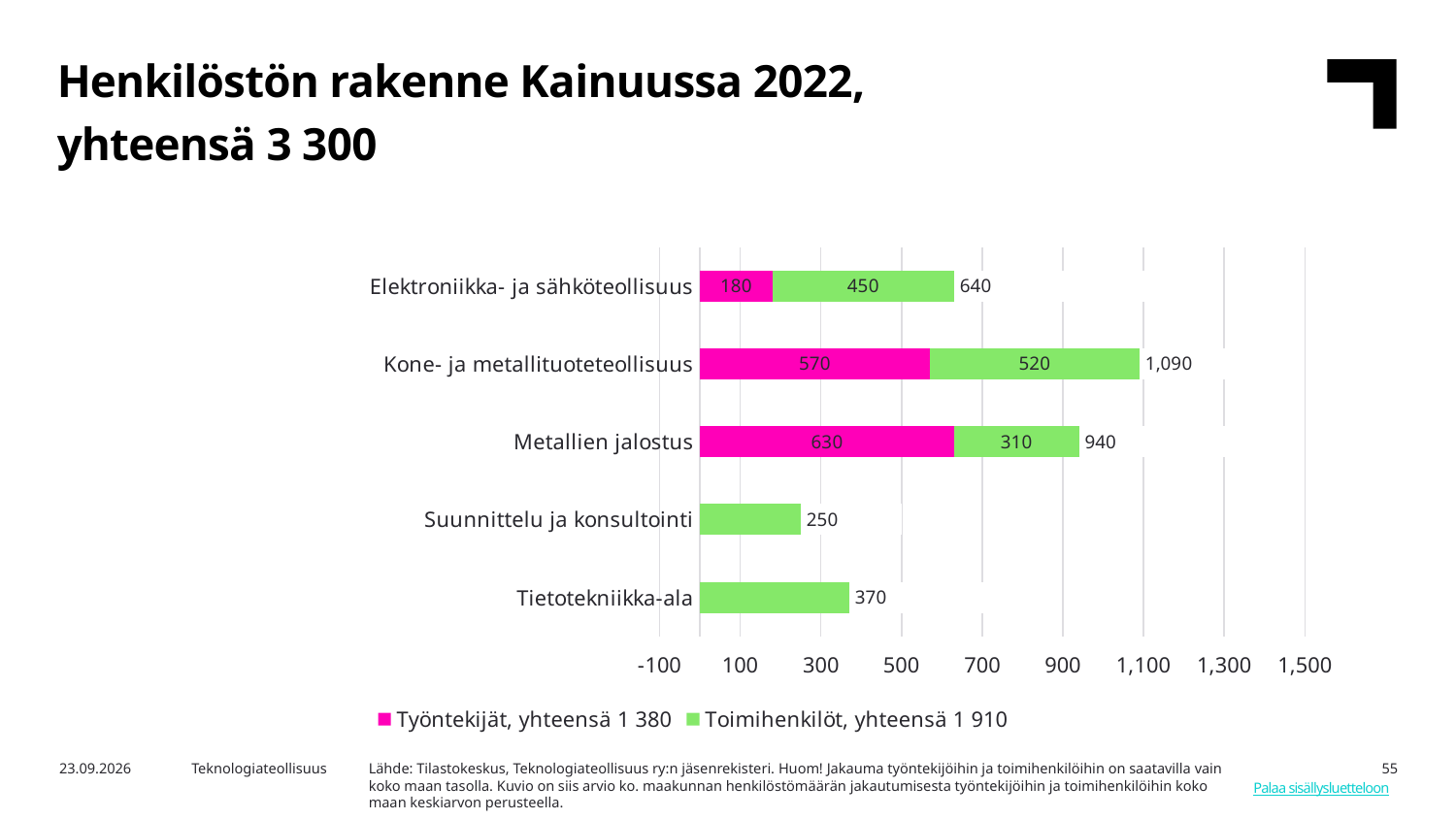
How many categories are shown on the chart? 5 How many series does the legend list? 2 What kind of chart is shown on the slide? Stacked bar chart What is the Toimihenkilöt value for Elektroniikka- ja sähköteollisuus? 450 What is the difference between the Työntekijät values for Metallien jalostus and Elektroniikka- ja sähköteollisuus? 450 What is the Työntekijät value for Kone- ja metallituoteteollisuus? 570 Which category has the lowest total? Suunnittelu ja konsultointi What is the title of the chart slide? Henkilöstön rakenne Kainuussa 2022, yhteensä 3 300 Which category has the highest total? Kone- ja metallituoteteollisuus What is the total for the Metallien jalostus bar? 940 Which is larger: the Toimihenkilöt value for Tietotekniikka-ala or for Suunnittelu ja konsultointi? Tietotekniikka-ala Which category has the highest Työntekijät value? Metallien jalostus